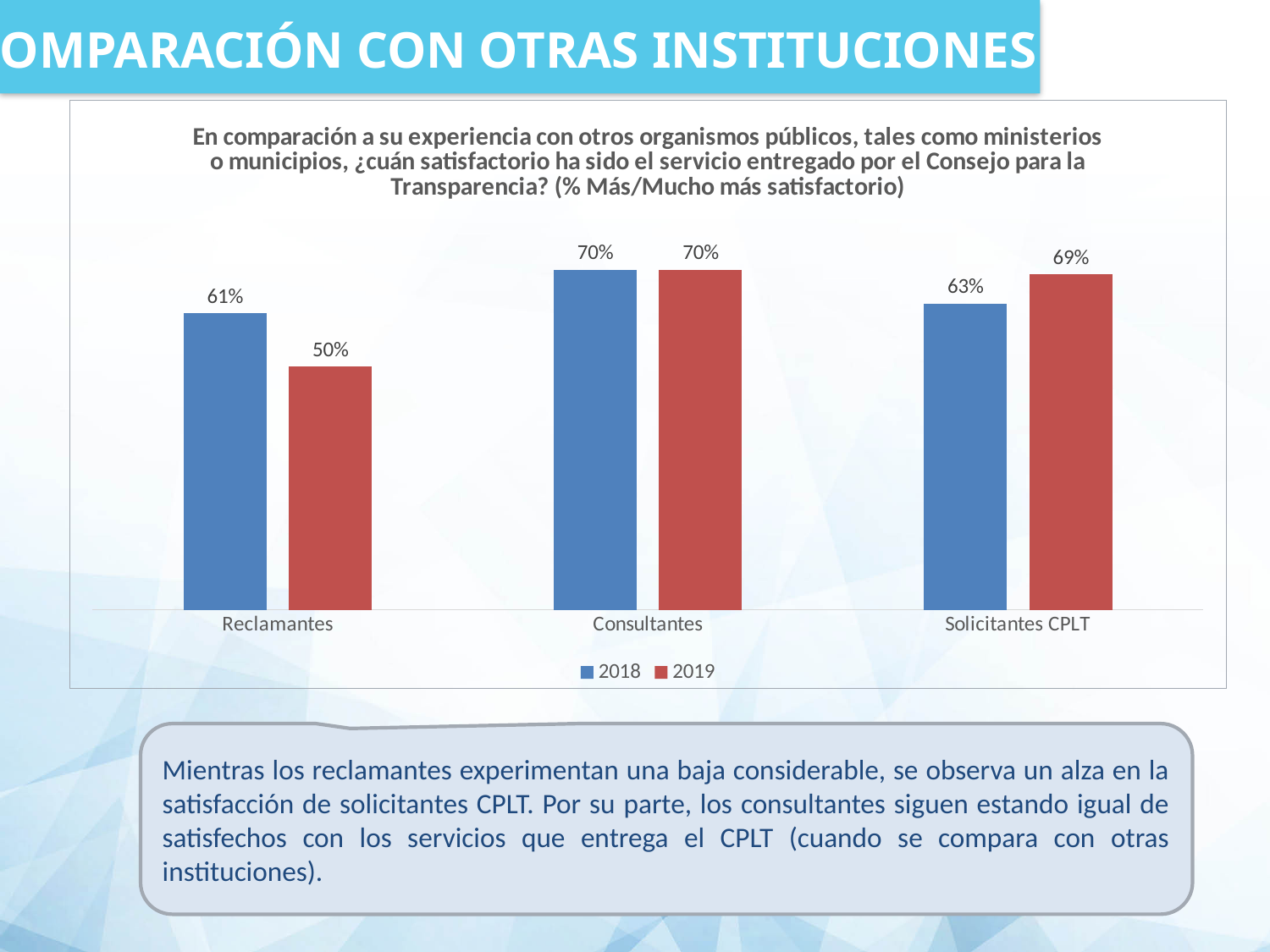
How many categories are shown on the x axis? 3 What is the difference between the 2018 and 2019 values for Reclamantes? 11% What kind of chart is shown on the slide? Bar chart What is the difference between the 2019 and 2018 values for Solicitantes CPLT? 6% Which category has the highest 2018 value? Consultantes Which category has the lowest 2019 value? Reclamantes What is the 2019 value for Reclamantes? 50% What is the 2019 value for Solicitantes CPLT? 69% How many series does the legend list? 2 What is the 2018 value for Reclamantes? 61% Which is larger for Solicitantes CPLT, the 2018 value or the 2019 value? 2019 What is the 2018 value for Consultantes? 70%